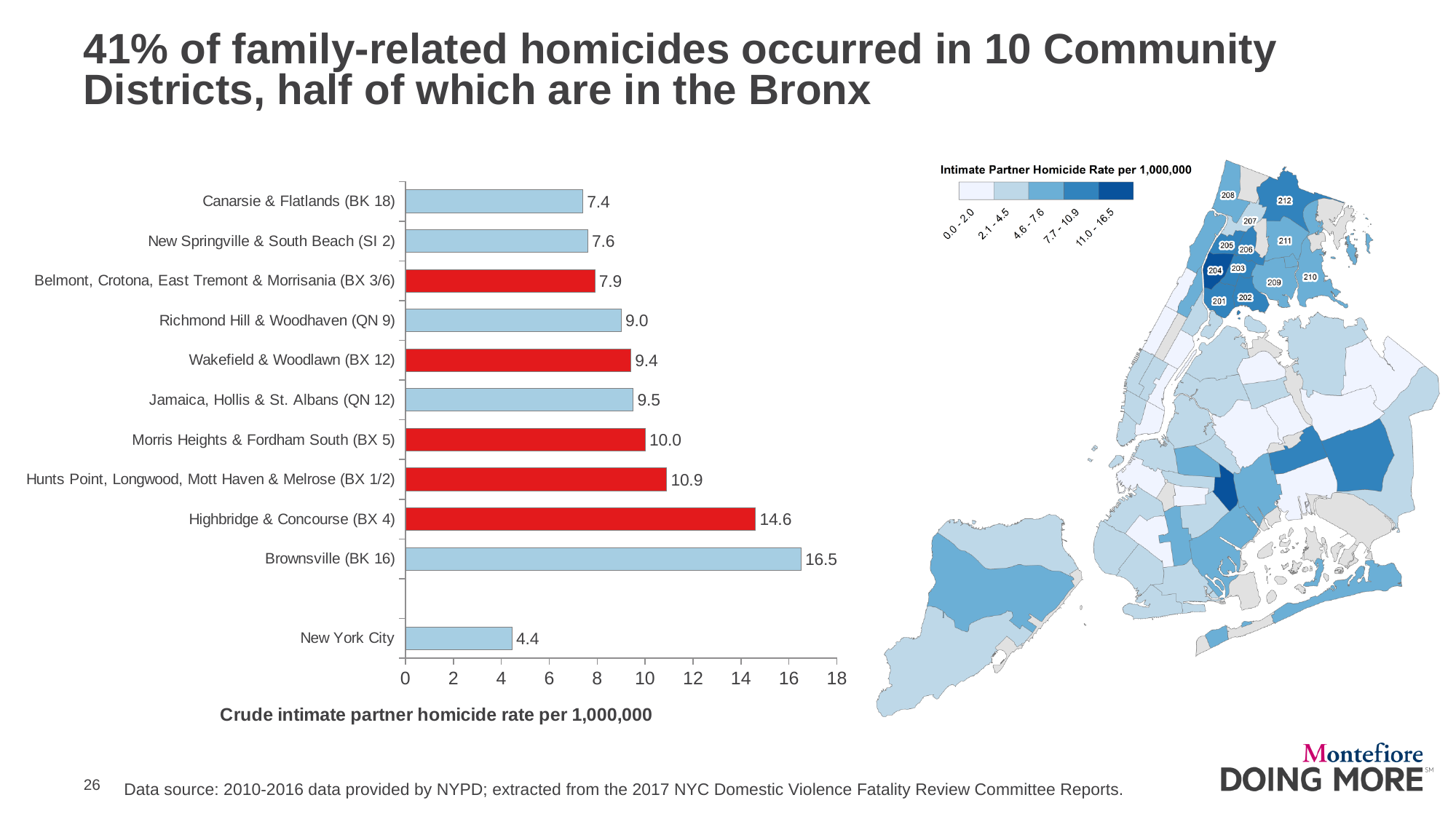
What is the difference between the rates for Brownsville (BK 16) and Highbridge & Concourse (BX 4)? 1.9 Is the value for Hunts Point, Longwood, Mott Haven & Melrose (BX 1/2) greater or less than 10? greater Which community district has the highest crude intimate partner homicide rate in the bar chart? Brownsville (BK 16) What is the label on the x axis of the bar chart? Crude intimate partner homicide rate per 1,000,000 What is the crude intimate partner homicide rate per 1,000,000 for New York City overall? 4.4 What is the crude intimate partner homicide rate per 1,000,000 for Brownsville (BK 16)? 16.5 Among the 10 community districts shown, which has the lowest crude intimate partner homicide rate? Canarsie & Flatlands (BK 18) How many community districts are shown in the bar chart, excluding the New York City bar? 10 How many bars in the bar chart are coloured red? 5 What is the value shown for Highbridge & Concourse (BX 4)? 14.6 What kind of chart is used to show the crude intimate partner homicide rates? Bar chart Which has a higher rate: Wakefield & Woodlawn (BX 12) or Richmond Hill & Woodhaven (QN 9)? Wakefield & Woodlawn (BX 12)